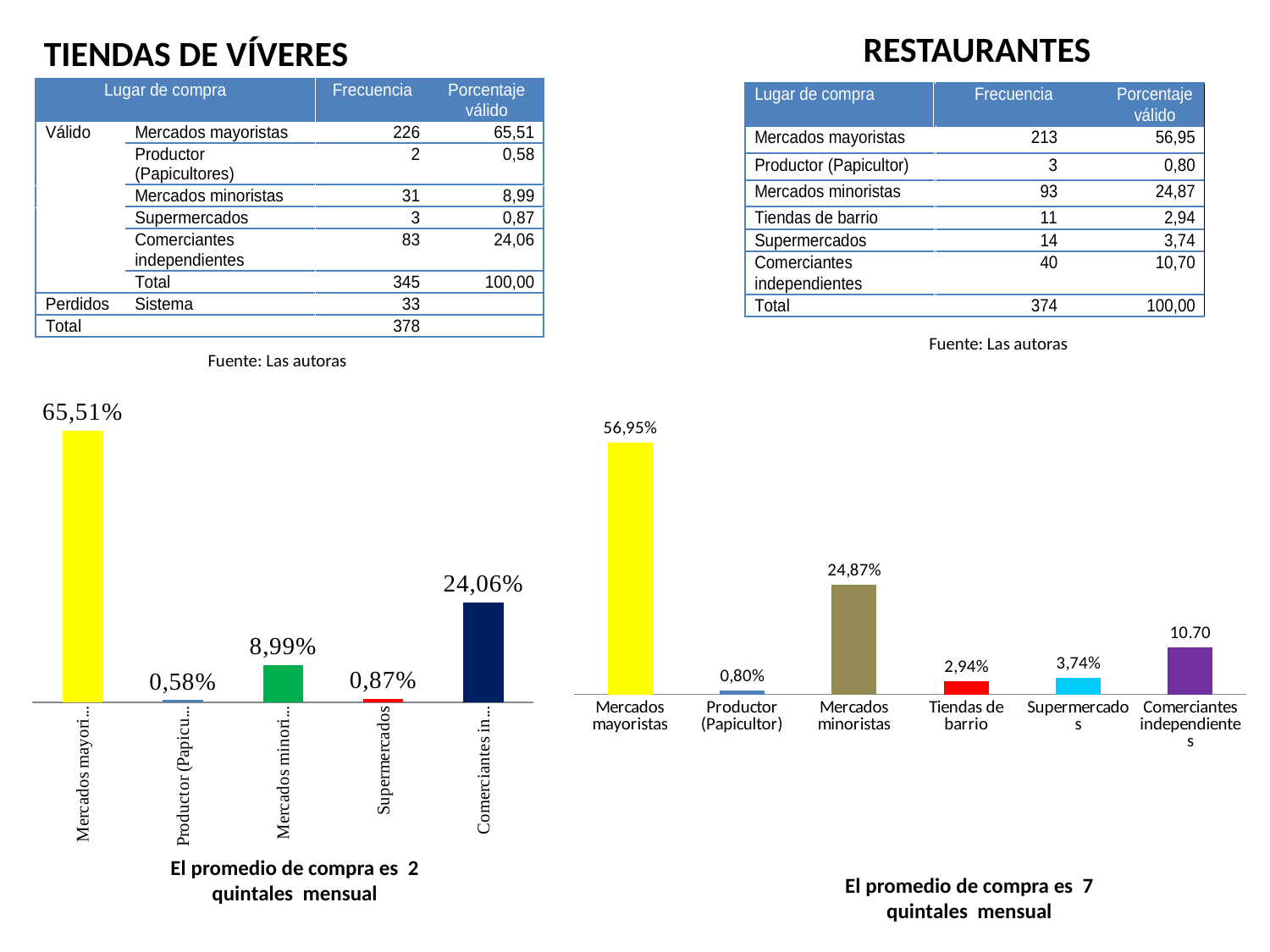
In the right chart (Restaurantes), which is larger, Supermercados or Tiendas de barrio? Supermercados In the left chart (Tiendas de víveres), what is the difference between Comerciantes independientes and Mercados minoristas? 15,07% In the right chart (Restaurantes), how many categories are shown? 6 In the right chart (Restaurantes), what colour is the bar for Comerciantes independientes? Purple In the left chart (Tiendas de víveres), what is the value for Mercados mayoristas? 65,51% In the right chart (Restaurantes), what is the value for Tiendas de barrio? 2,94% What type of chart is the right chart (Restaurantes)? Bar chart In the left chart (Tiendas de víveres), how many bars are plotted? 5 In the right chart (Restaurantes), which category has the highest value? Mercados mayoristas In the left chart (Tiendas de víveres), which category has the lowest value? Productor (Papicultores) In the left chart (Tiendas de víveres), what is the value for Supermercados? 0,87% In the right chart (Restaurantes), what is the value for Mercados minoristas? 24,87%